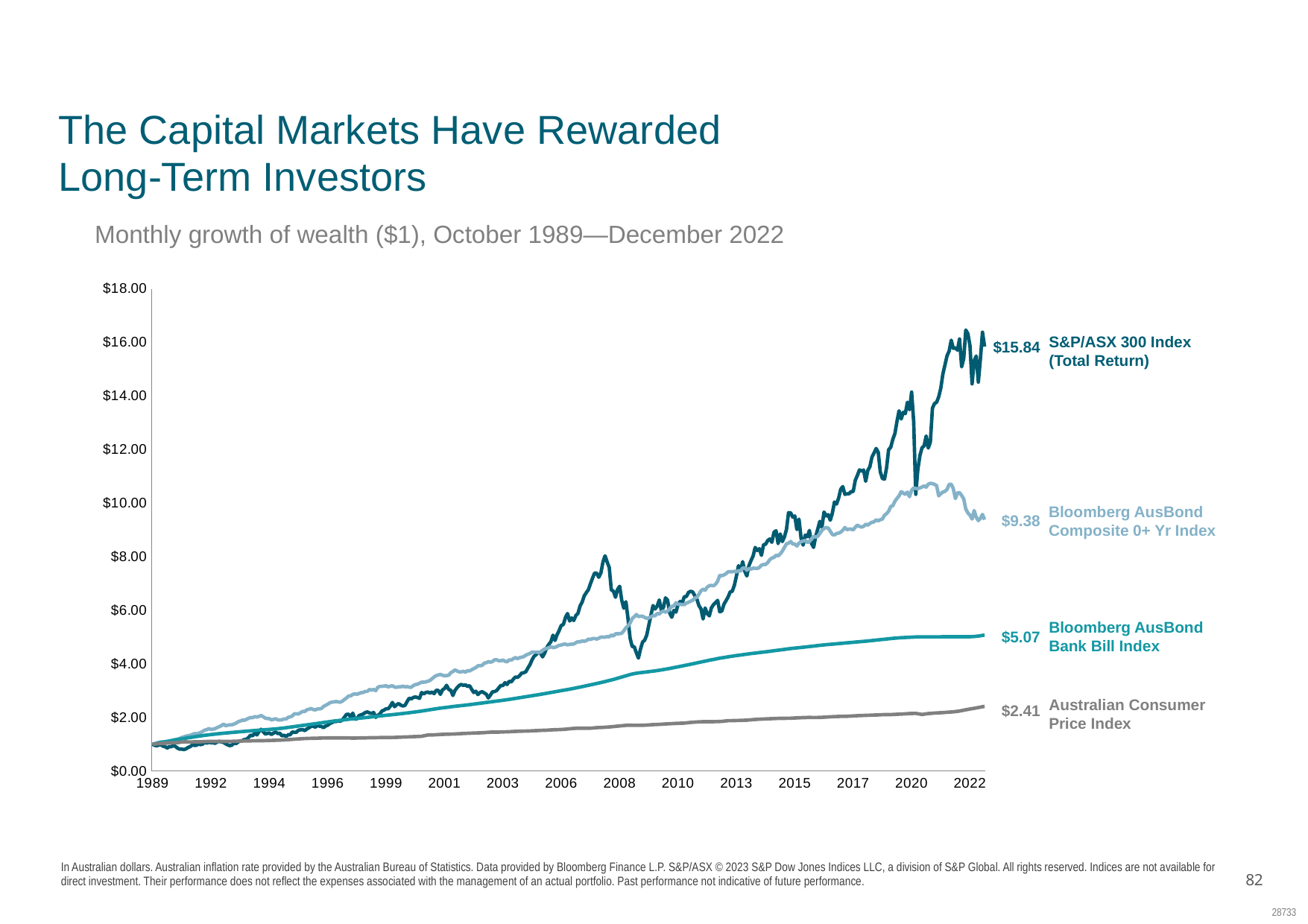
What is the subtitle of the chart? Monthly growth of wealth ($1), October 1989—December 2022 Which series has the highest ending value? S&P/ASX 300 Index (Total Return) Which has a larger ending value, the Bloomberg AusBond Bank Bill Index or the Australian Consumer Price Index? Bloomberg AusBond Bank Bill Index What is the ending value shown for the Bloomberg AusBond Bank Bill Index? $5.07 Which series has the lowest ending value? Australian Consumer Price Index What is the difference between the ending values of the S&P/ASX 300 Index (Total Return) and the Bloomberg AusBond Composite 0+ Yr Index? $6.46 What kind of chart is shown on the slide? Line chart What is the ending value shown for the S&P/ASX 300 Index (Total Return)? $15.84 What is the ending value shown for the Bloomberg AusBond Composite 0+ Yr Index? $9.38 How many series are plotted on the chart? 4 What is the difference between the ending values of the Bloomberg AusBond Bank Bill Index and the Australian Consumer Price Index? $2.66 What is the ending value shown for the Australian Consumer Price Index? $2.41